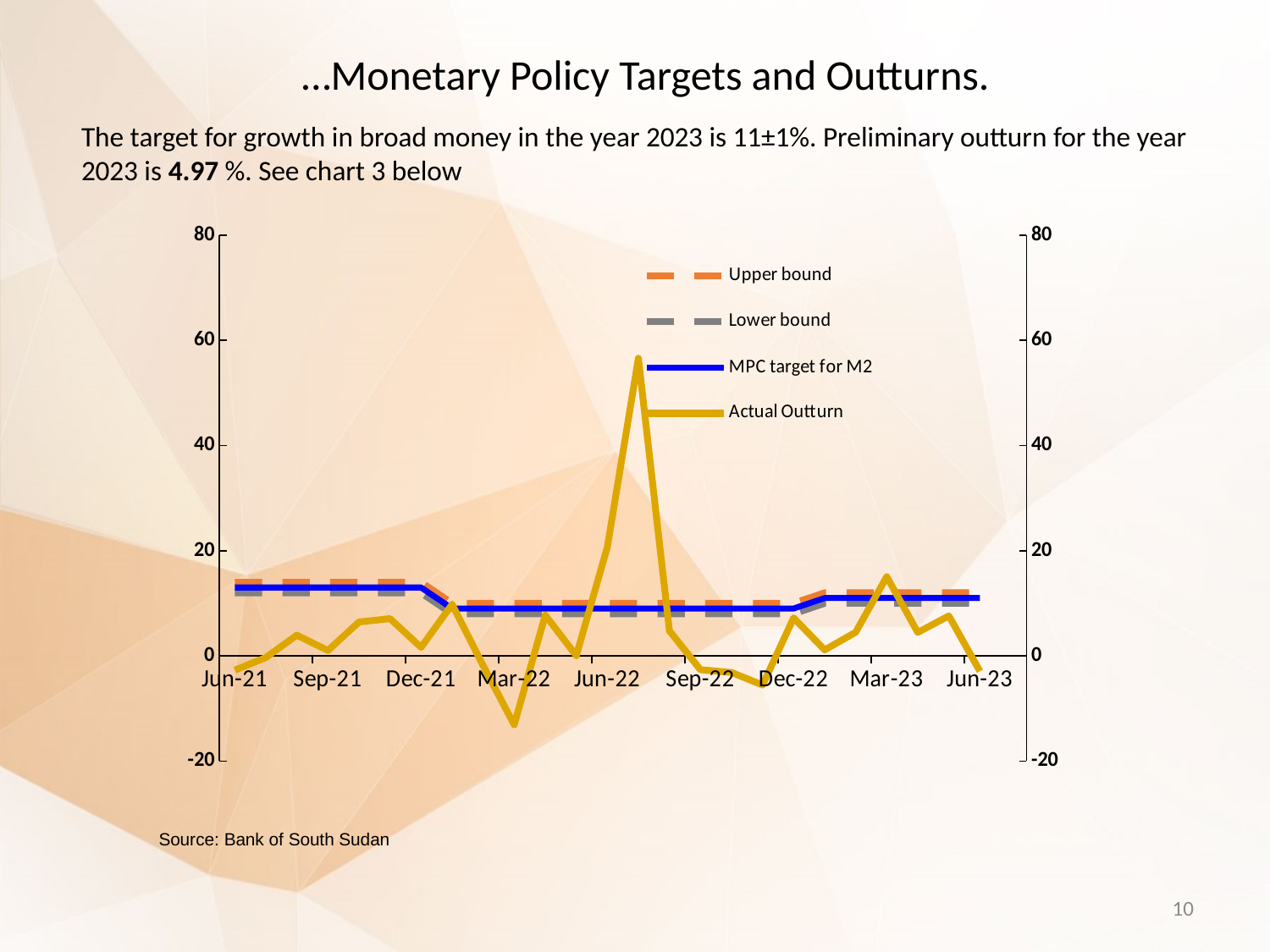
At Mar-22, which is higher: the Actual Outturn or the MPC target for M2? MPC target for M2 What kind of chart is shown on the slide? line chart What source is cited below the chart? Bank of South Sudan What is the highest value shown on the chart's vertical axis? 80 How many date labels are shown along the x axis of the chart? 9 Is the Upper bound at Sep-21 greater or less than 20? less At Jun-22, which is higher: the Actual Outturn or the MPC target for M2? Actual Outturn Is the MPC target for M2 at Sep-21 greater or less than 20? less Does the MPC target for M2 rise or fall between Dec-21 and Mar-22? fall How many series does the chart legend list? 4 Is the lowest value of the Actual Outturn series greater or less than -10? less